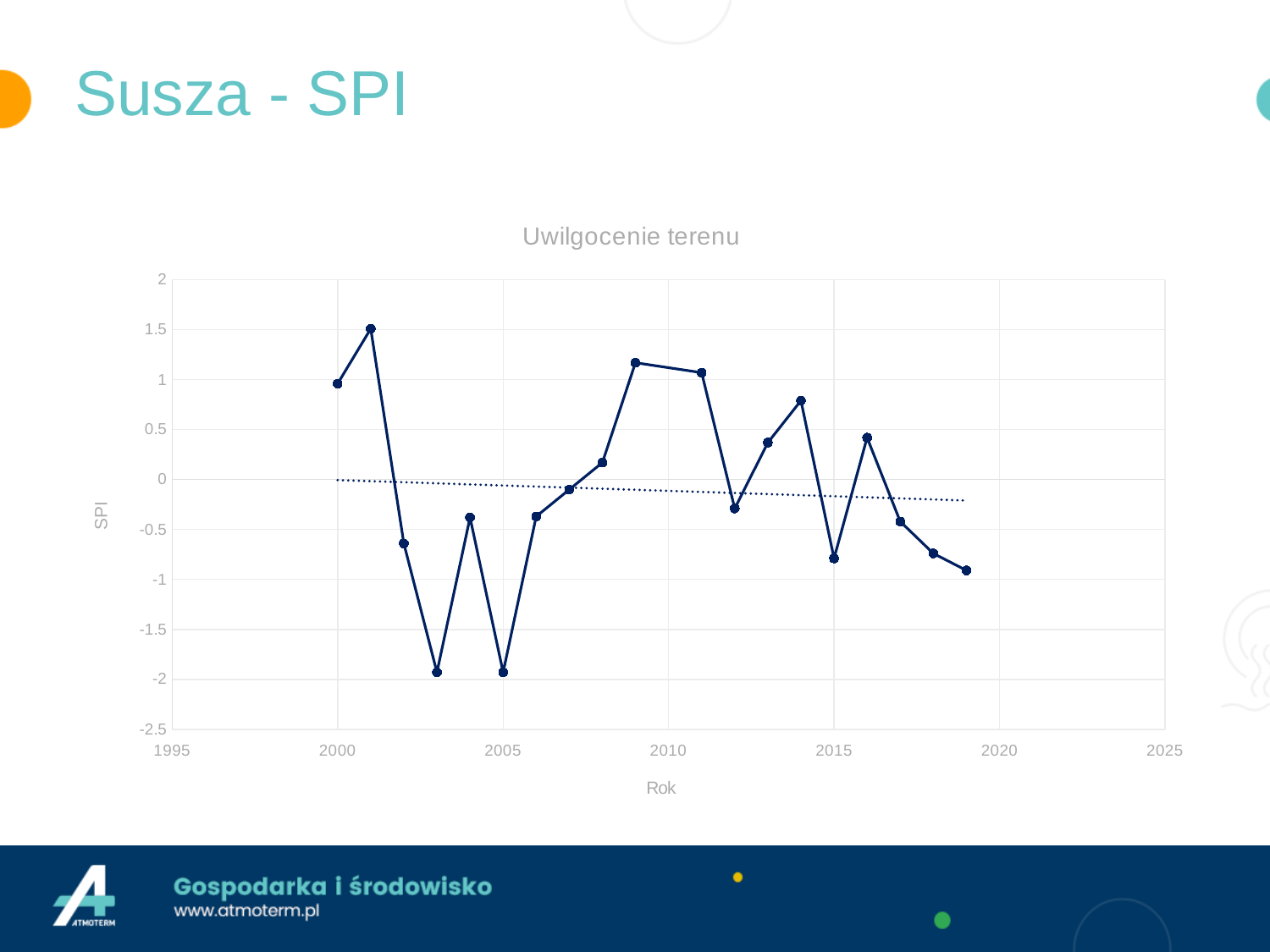
Does the dotted trend line rise or fall from 2000 to 2019? fall Is the SPI value for 2019 greater or less than -0.5? less Is the SPI value for 2003 greater or less than -1.5? less Which year has the larger SPI value, 2013 or 2014? 2014 Which year has the larger SPI value, 2001 or 2009? 2001 What is the label of the x axis? Rok What is the title of the chart? Uwilgocenie terenu In which year is the SPI value highest? 2001 Is the SPI value for 2009 greater or less than 1? greater What kind of chart is shown on the slide? line chart